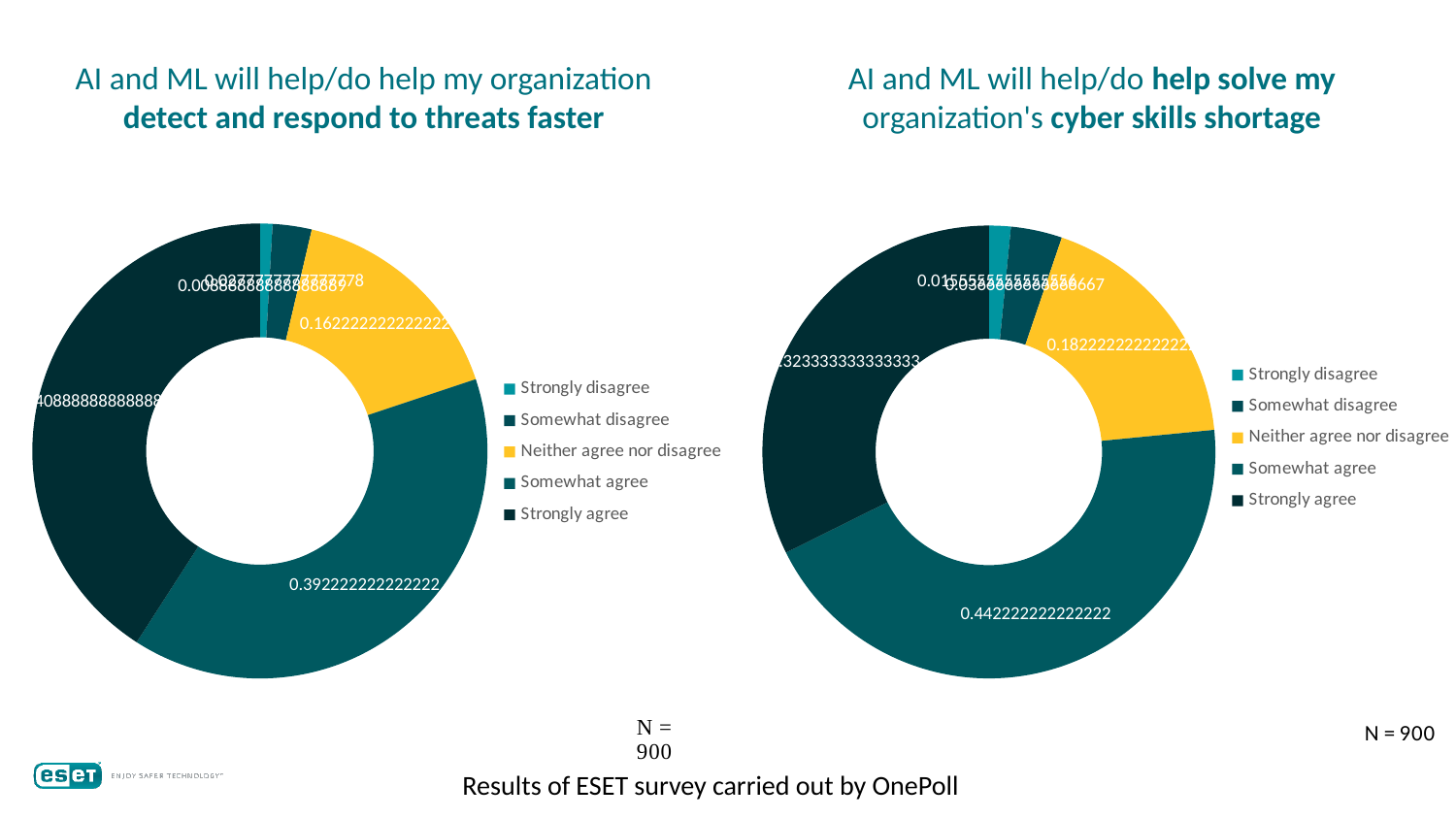
How many categories does the legend list for the right chart, 'AI and ML will help/do help solve my organization's cyber skills shortage'? 5 In the left chart ('detect and respond to threats faster'), what is the difference between the Somewhat agree value and the Neither agree nor disagree value? 0.23 In the left chart ('detect and respond to threats faster'), what is the value shown for Somewhat agree? 0.392222222222222 What sample size (N) is stated for the charts on the slide? N = 900 In the right chart ('cyber skills shortage'), what is the value shown for Somewhat agree? 0.442222222222222 In the right chart ('cyber skills shortage'), which category has the smallest share? Strongly disagree In the left chart ('detect and respond to threats faster'), which is larger: Somewhat agree or Neither agree nor disagree? Somewhat agree Which colour represents 'Neither agree nor disagree' in both charts? Yellow In the left chart ('detect and respond to threats faster'), what is the value shown for Neither agree nor disagree? 0.162222222222222 What kind of chart is used on the left of the slide, titled 'AI and ML will help/do help my organization detect and respond to threats faster'? Doughnut (pie) chart In the left chart ('detect and respond to threats faster'), which category has the smallest share? Strongly disagree In the right chart ('cyber skills shortage'), which category has the largest share? Somewhat agree